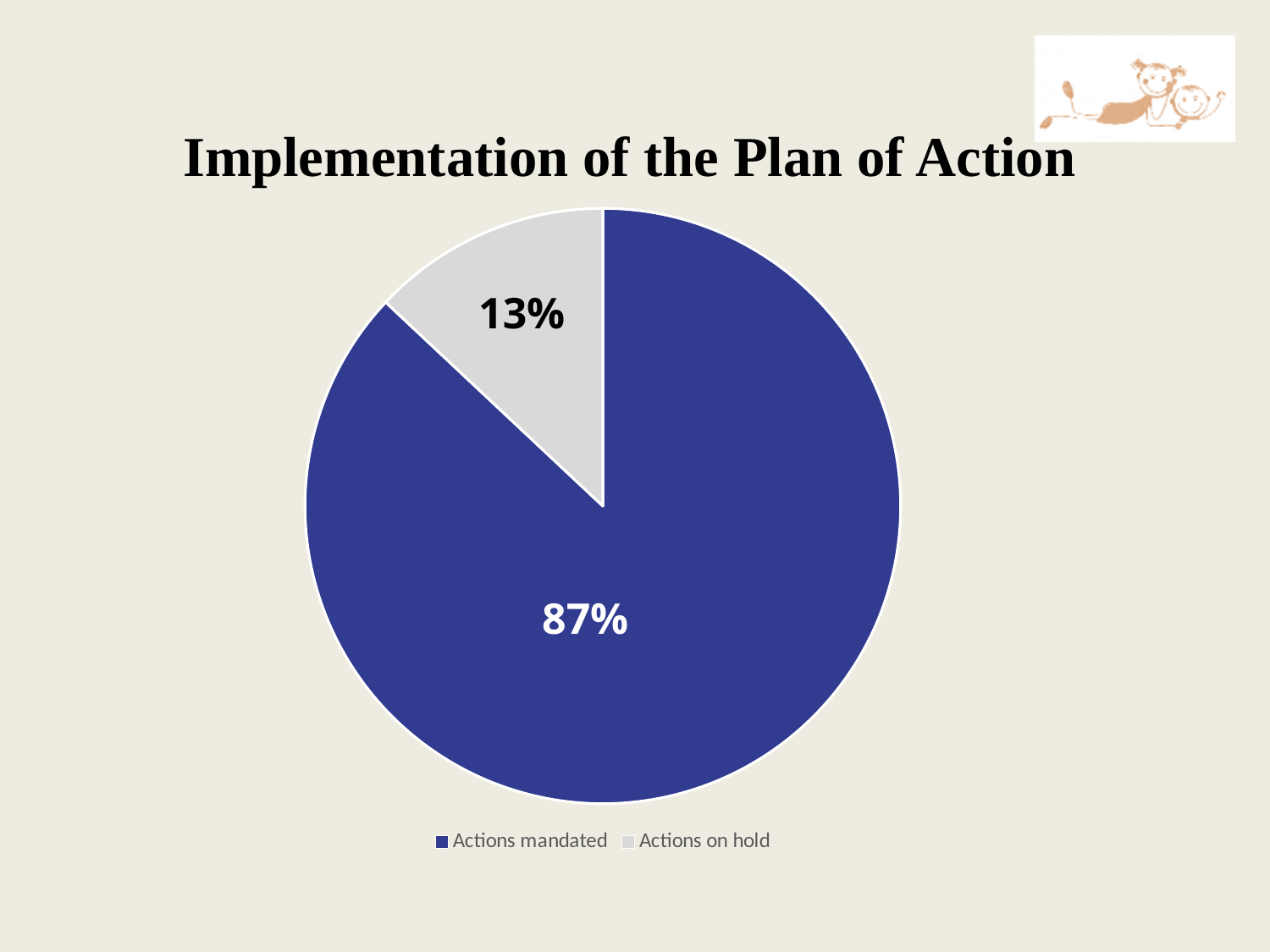
How many slices does the pie chart have? 2 What kind of chart is shown on the slide? pie chart What is the difference in percentage points between the "Actions mandated" slice and the "Actions on hold" slice? 74 How many entries does the legend list? 2 Which slice of the pie is the largest? Actions mandated What share of the pie is labelled "Actions on hold"? 13% Which is larger, the share for "Actions mandated" or the share for "Actions on hold"? Actions mandated What colour is the "Actions mandated" slice? blue Which slice of the pie is the smallest? Actions on hold What is the title of the slide containing the chart? Implementation of the Plan of Action What share of the pie is labelled "Actions mandated"? 87%